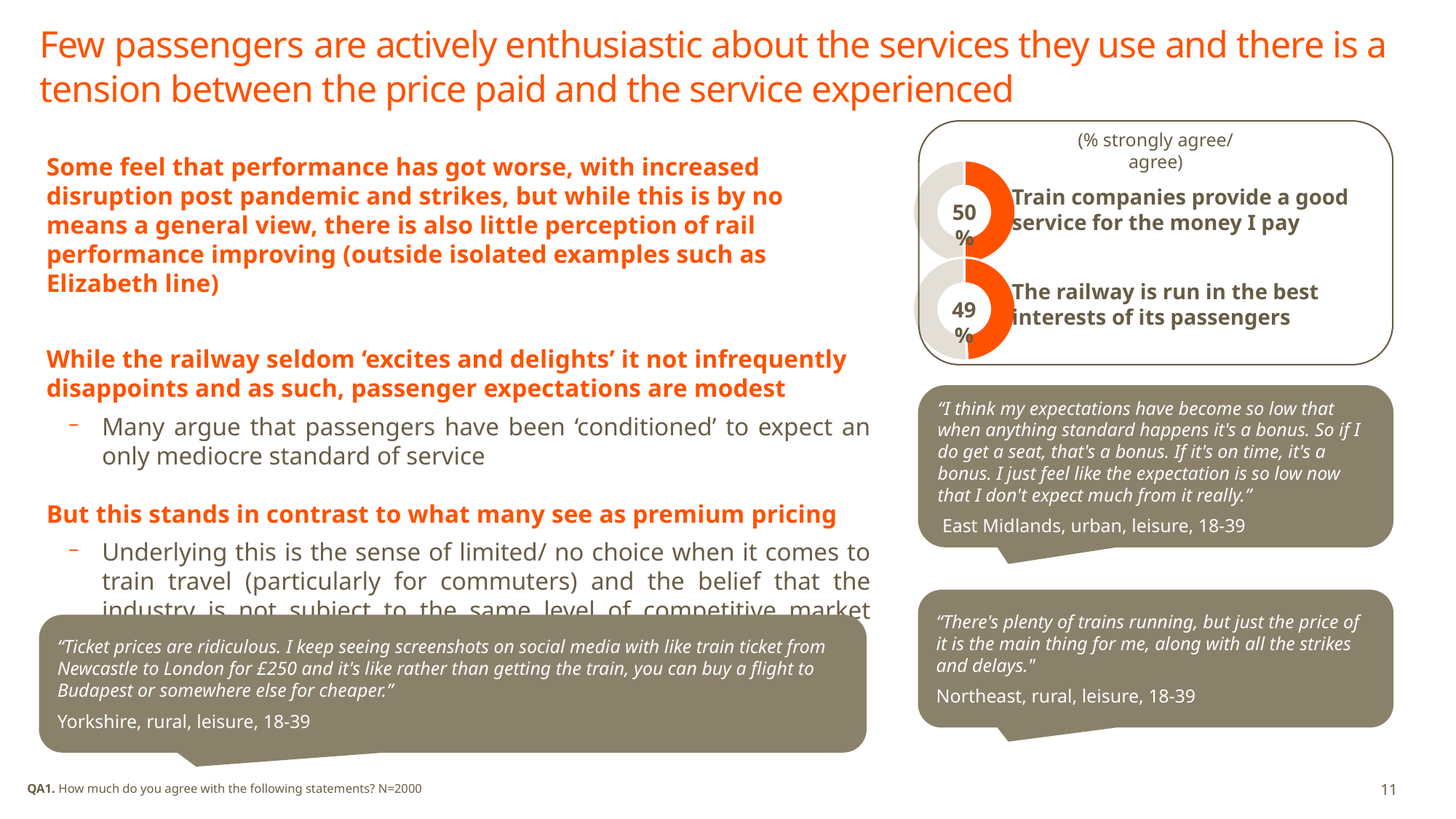
What percentage of passengers strongly agree or agree that train companies provide a good service for the money they pay? 50% How many donut charts are shown on the slide? 2 What percentage of passengers strongly agree or agree that the railway is run in the best interests of its passengers? 49% What measure do the donut charts show, according to the label above them? % strongly agree/ agree Which statement has the lower agreement percentage in the donut charts? The railway is run in the best interests of its passengers Which statement has the higher agreement percentage: 'Train companies provide a good service for the money I pay' or 'The railway is run in the best interests of its passengers'? Train companies provide a good service for the money I pay In the donut chart for 'The railway is run in the best interests of its passengers', is the agreement value greater or less than 50%? less What type of chart is used to show the agreement percentages on the right of the slide? Donut chart What is the difference in percentage points between the agreement for 'Train companies provide a good service for the money I pay' and 'The railway is run in the best interests of its passengers'? 1 percentage point What colour is used for the agreement share in the donut charts? Orange What is the sample size (N) for the survey question shown in the donut charts? N=2000